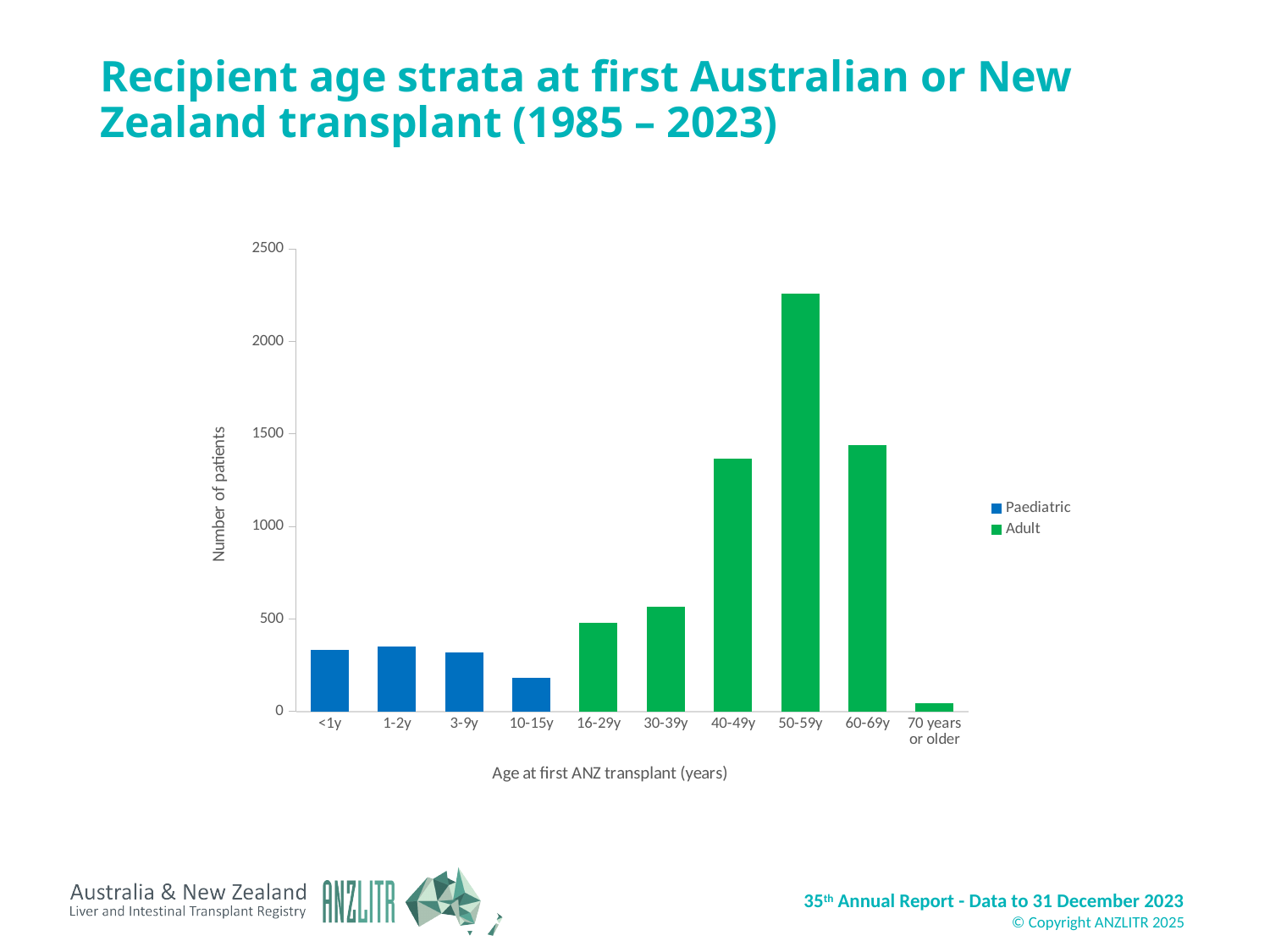
Is the number of patients for 70 years or older greater or less than 500? less Is the number of patients for 40-49y greater or less than 1000? greater Which has more patients, 50-59y or 60-69y? 50-59y Which age group has the highest number of patients? 50-59y What kind of chart is shown on the slide? bar chart Which has more patients, 3-9y or 10-15y? 3-9y How many series does the legend list? 2 Which series is shown in green in the legend? Adult Is the number of patients for 50-59y greater or less than 2000? greater Which age group has the lowest number of patients? 70 years or older How many age categories are shown on the x axis? 10